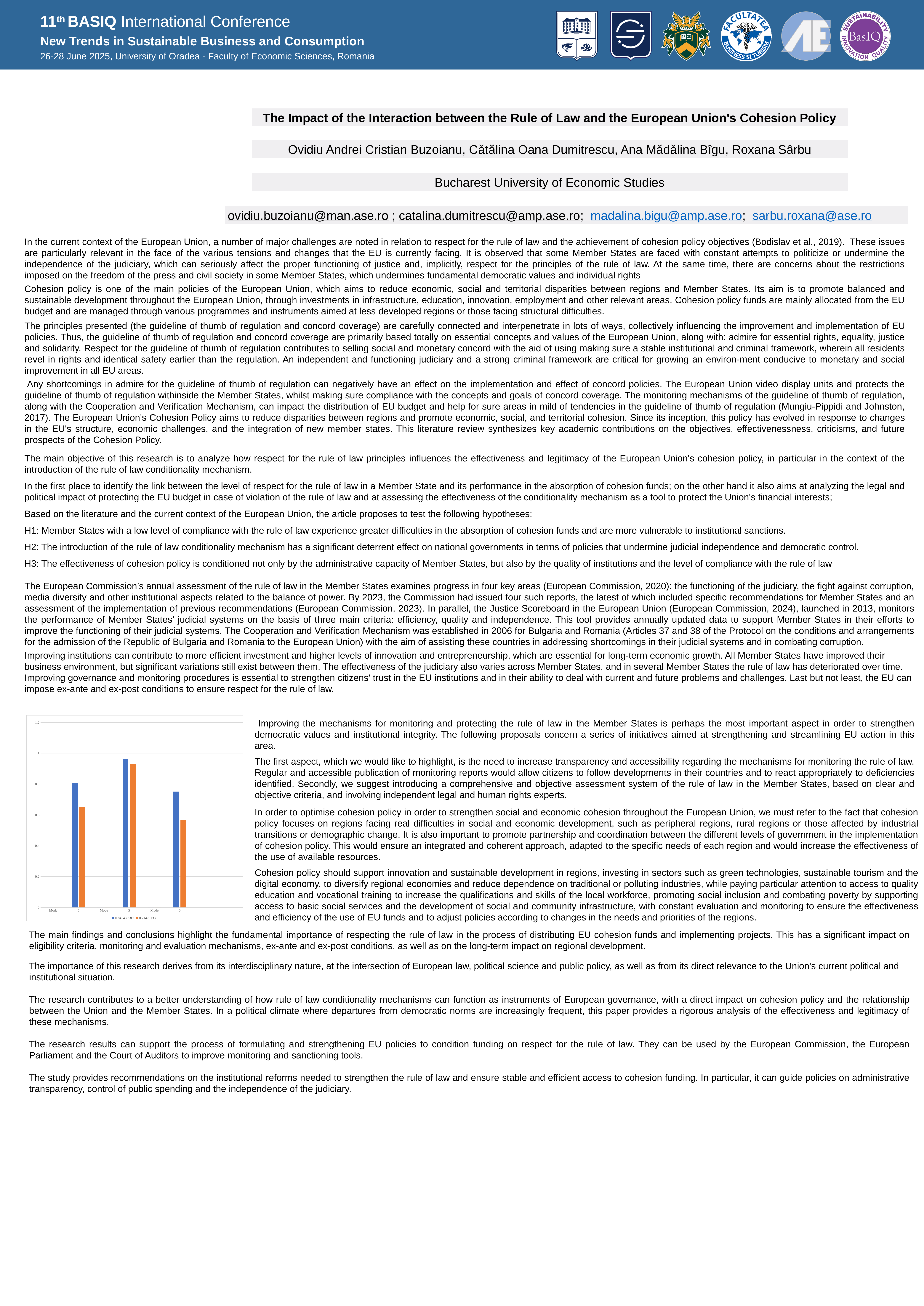
What colours are used for the two series in the bar chart? blue and orange In the third group of the bar chart, is the blue bar or the orange bar taller? the blue bar What kind of chart is shown at the bottom left of the slide? bar chart In the bar chart, which group of bars has the shortest orange bar? the third group Is the value of the orange bar in the first group of the bar chart greater or less than 0.8? less In the first group of the bar chart, is the blue bar or the orange bar taller? the blue bar How many groups of bars are plotted in the bar chart? 3 Is the value of the blue bar in the second group of the bar chart greater or less than 0.8? greater How many series does the legend of the bar chart list? 2 In the bar chart, which group of bars has the tallest orange bar? the second group In the bar chart, which group of bars has the shortest blue bar? the third group In the bar chart, which group of bars has the tallest blue bar? the second group